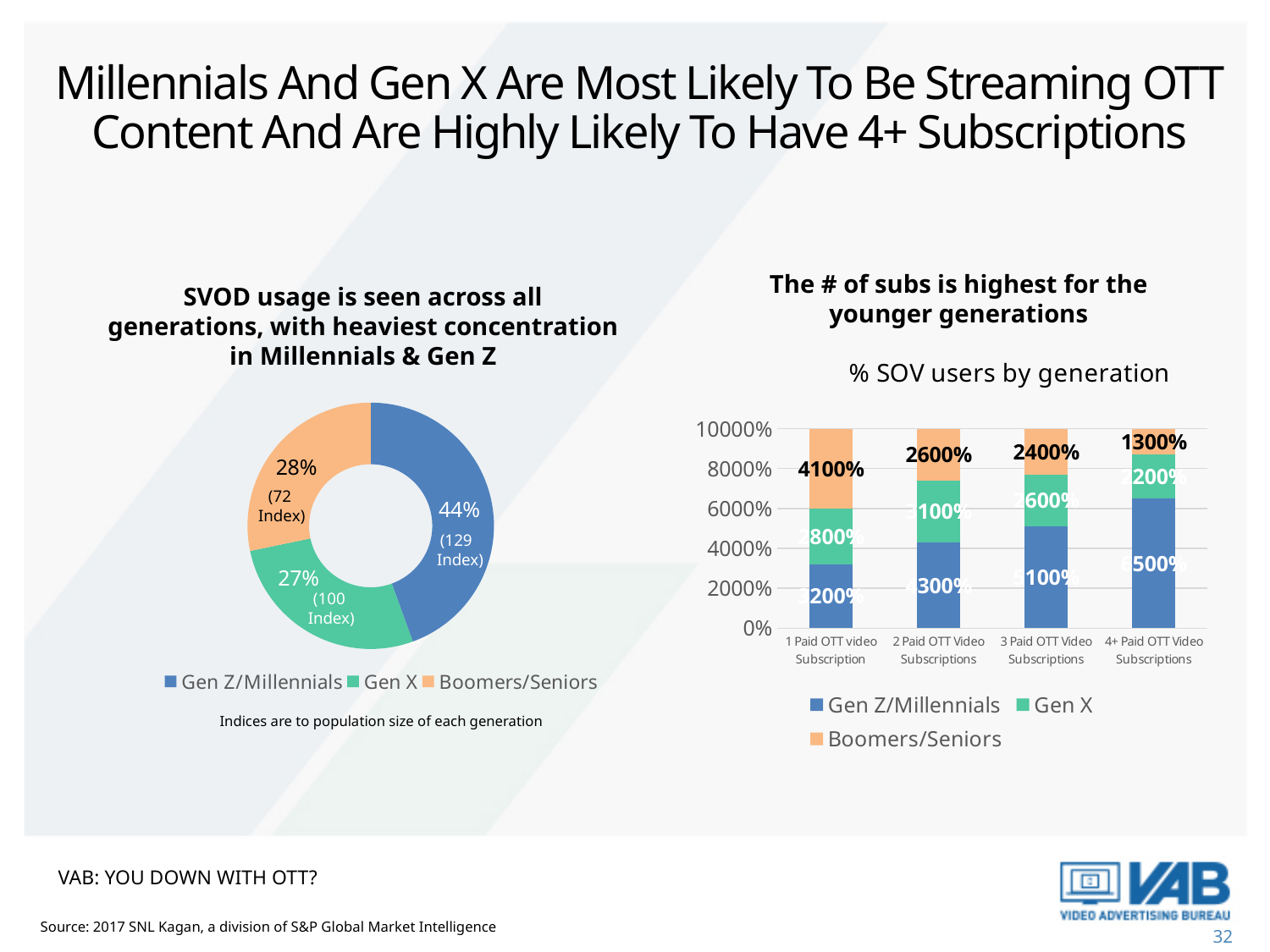
In the left donut chart, what index value is shown for Gen Z/Millennials? 129 Index In the left donut chart, what share is shown for Boomers/Seniors? 28% In the left donut chart, what share is shown for Gen Z/Millennials? 44% In the right chart '% SOV users by generation', how many subscription categories are shown on the x axis? 4 In the right chart '% SOV users by generation', what is the Boomers/Seniors value for 1 Paid OTT video Subscription? 4100% In the left donut chart, which generation has the largest slice? Gen Z/Millennials In the right chart '% SOV users by generation', what is the Boomers/Seniors value for 4+ Paid OTT Video Subscriptions? 1300% How many entries does the legend of the left donut chart list? 3 What kind of chart is the right chart titled '% SOV users by generation'? Stacked bar chart In the right chart '% SOV users by generation', do the Boomers/Seniors values rise or fall from 1 subscription to 4+ subscriptions? Fall What kind of chart is the left chart titled 'SVOD usage is seen across all generations'? Pie (donut) chart In the left donut chart, what share is shown for Gen X? 27%